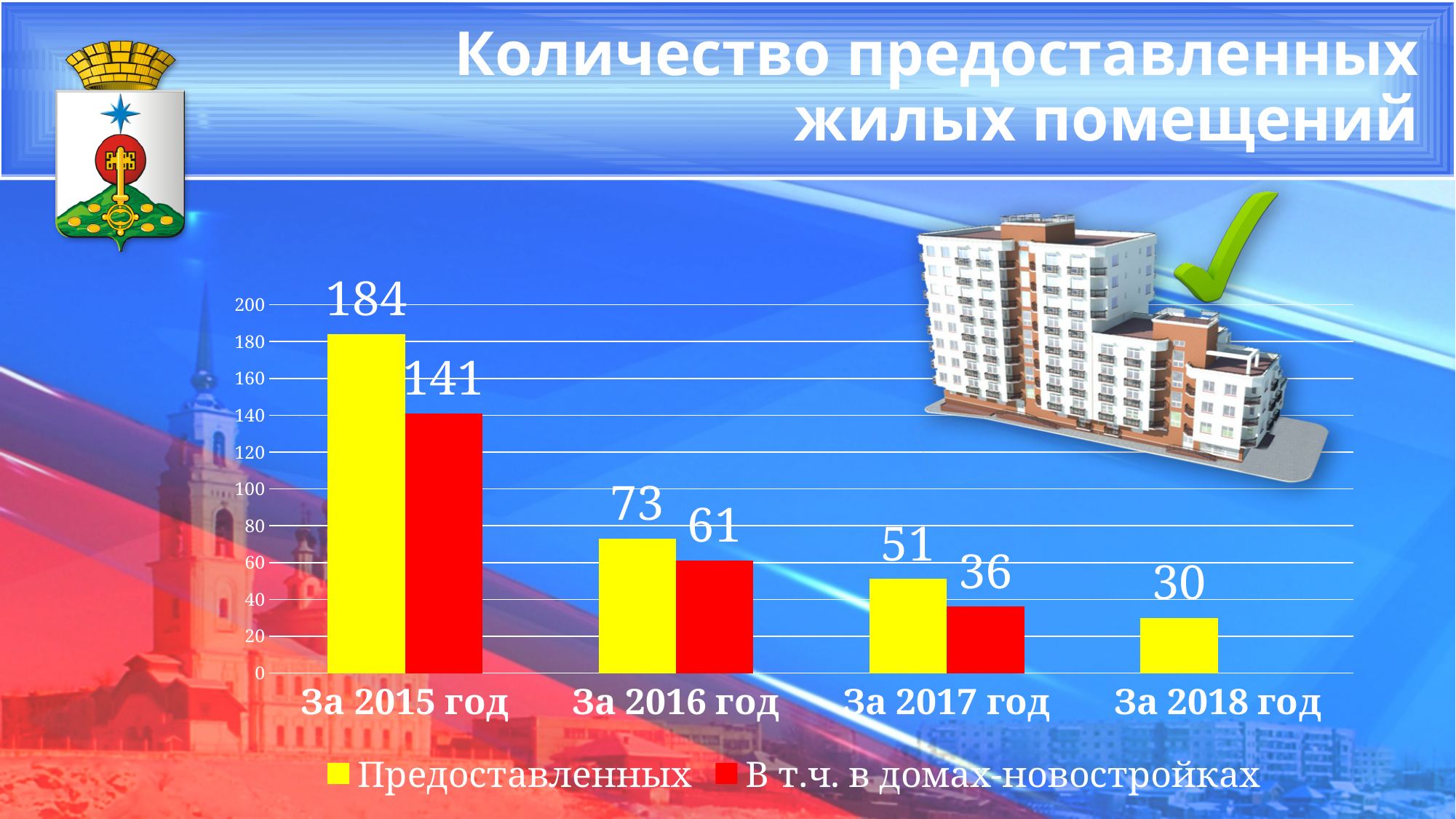
Do the 'Предоставленных' values rise or fall from 2015 to 2018? Fall How many year categories are shown on the x axis? 4 Which year has the highest value for 'Предоставленных'? За 2015 год What is the value of 'В т.ч. в домах-новостройках' for 'За 2016 год'? 61 Which is larger: 'В т.ч. в домах-новостройках' for 'За 2015 год' or 'Предоставленных' for 'За 2016 год'? В т.ч. в домах-новостройках for За 2015 год Which year has the lowest value for 'Предоставленных'? За 2018 год What is the value of 'Предоставленных' for 'За 2018 год'? 30 What is the difference between the 'Предоставленных' values for 'За 2015 год' and 'За 2016 год'? 111 What kind of chart is shown on the slide? Bar chart How many series does the legend list? 2 What is the difference between 'Предоставленных' and 'В т.ч. в домах-новостройках' for 'За 2017 год'? 15 What is the value of 'Предоставленных' for 'За 2015 год'? 184